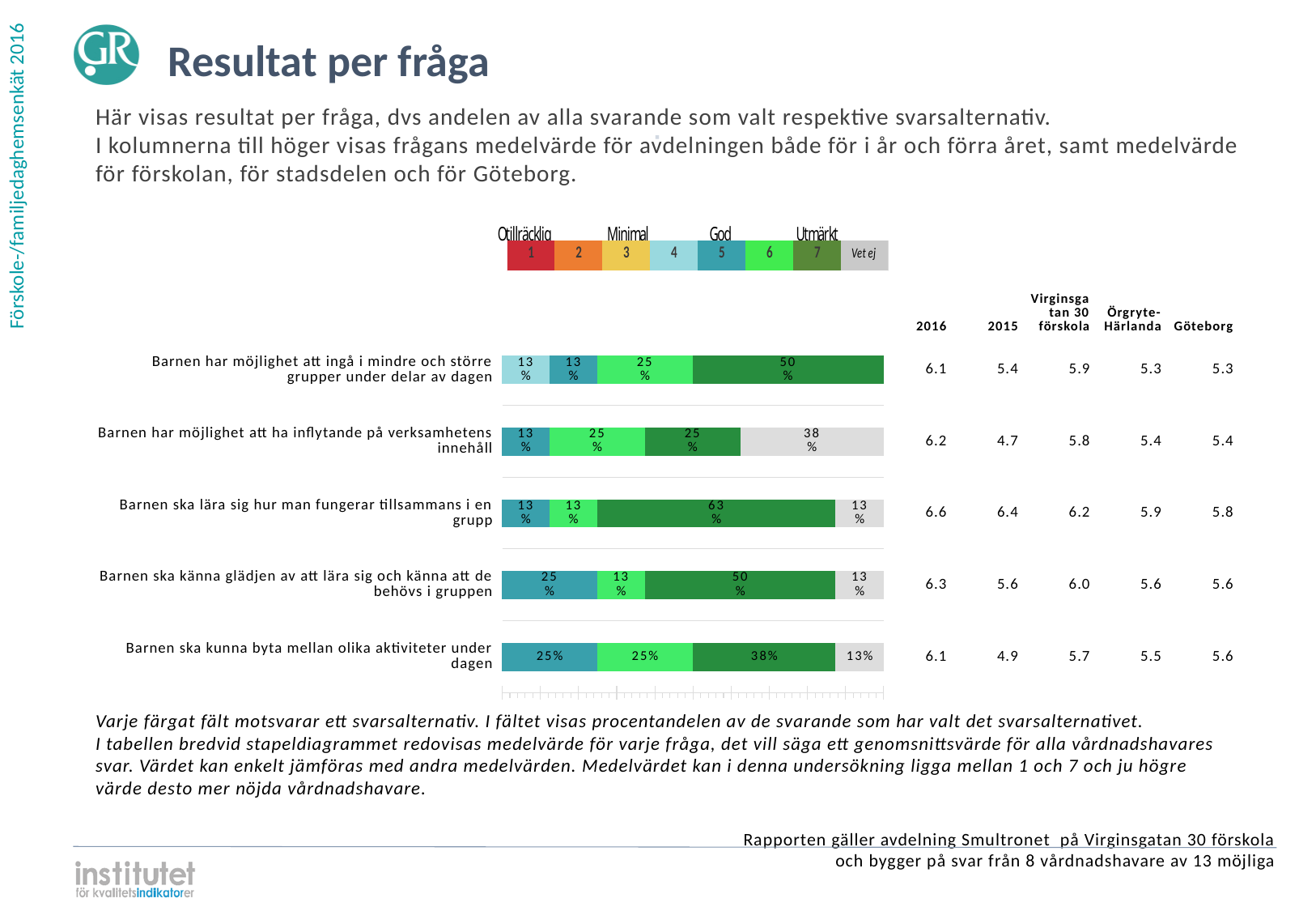
What kind of chart is shown on the slide? Stacked bar chart What is the difference between the answer 7 share for "Barnen ska lära sig hur man fungerar tillsammans i en grupp" (63%) and for "Barnen ska kunna byta mellan olika aktiviteter under dagen" (38%)? 25% Which question has the largest share of respondents choosing answer 7 (dark green)? Barnen ska lära sig hur man fungerar tillsammans i en grupp How many entries does the colour legend above the chart list, including "Vet ej"? 8 What percentage of respondents chose answer 7 (dark green) for "Barnen ska lära sig hur man fungerar tillsammans i en grupp"? 63% What percentage of respondents chose answer 5 (teal) for "Barnen ska kunna byta mellan olika aktiviteter under dagen"? 25% What percentage of respondents chose "Vet ej" (grey) for "Barnen har möjlighet att ha inflytande på verksamhetens innehåll"? 38% How many questions (categories) are plotted in the bar chart? 5 What is the combined share of answers 6 and 7 for "Barnen ska kunna byta mellan olika aktiviteter under dagen"? 63% Which legend label is shown above the scale values 1 and 2? Otillräcklig Which is larger: the answer 7 share for "Barnen ska känna glädjen av att lära sig och känna att de behövs i gruppen" or for "Barnen har möjlighet att ha inflytande på verksamhetens innehåll"? Barnen ska känna glädjen av att lära sig och känna att de behövs i gruppen What percentage of respondents chose answer 7 (dark green) for "Barnen har möjlighet att ingå i mindre och större grupper under delar av dagen"? 50%